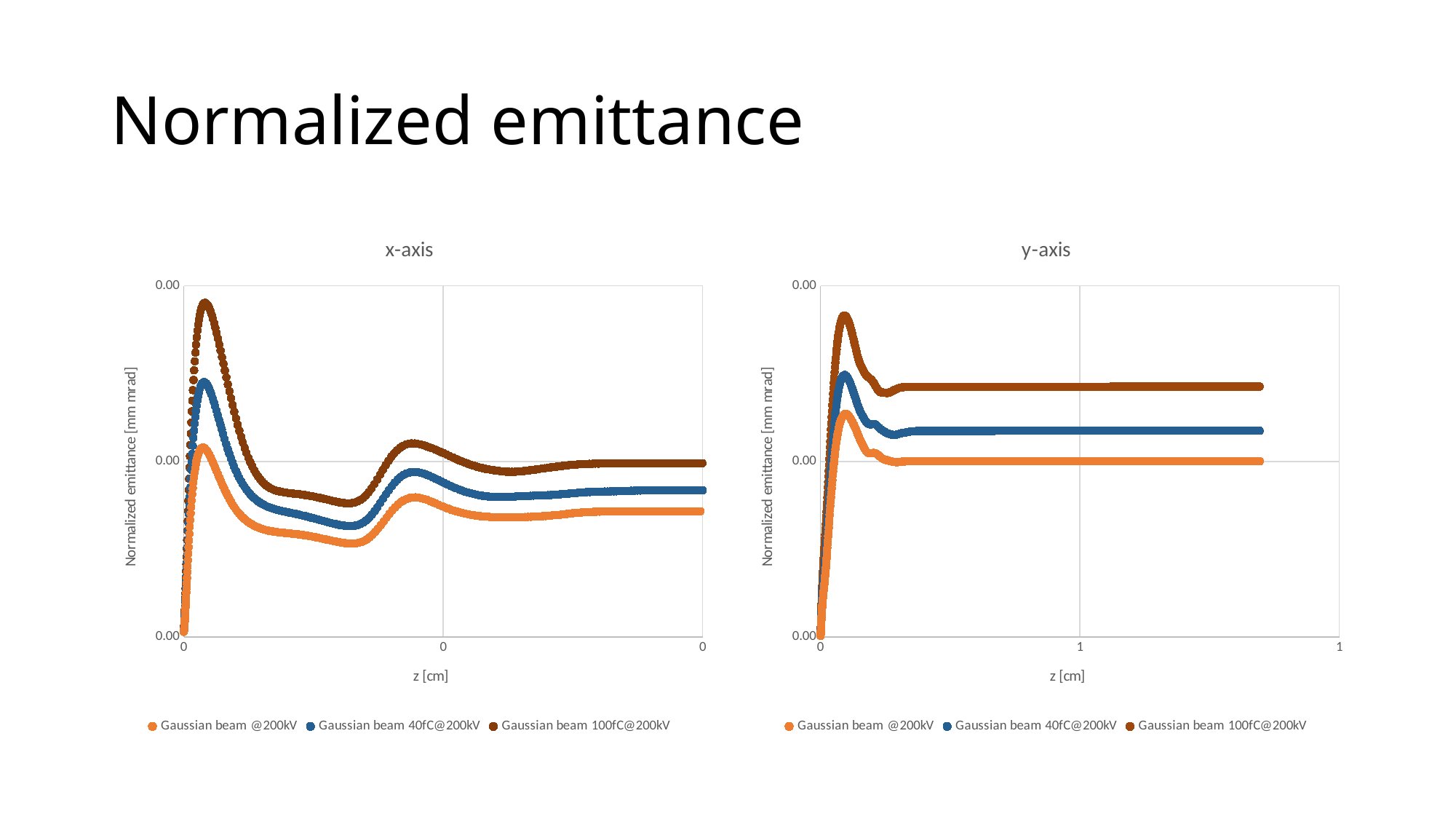
In the y-axis chart, which series is higher at the right end of the plot: Gaussian beam 40fC@200kV or Gaussian beam @200kV? Gaussian beam 40fC@200kV In the y-axis chart, which series reaches the highest peak? Gaussian beam 100fC@200kV How many series does the legend of the y-axis chart list? 3 What is the label of the horizontal axis in the y-axis chart? z [cm] How many series does the legend of the x-axis chart list? 3 What is the label of the vertical axis in the x-axis chart? Normalized emittance [mm mrad] In the y-axis chart, which series has the lowest values along the curve? Gaussian beam @200kV In the x-axis chart, which series is higher at the right end of the plot: Gaussian beam 100fC@200kV or Gaussian beam 40fC@200kV? Gaussian beam 100fC@200kV What kind of chart is the x-axis chart? Scatter chart What kind of chart is the y-axis chart? Scatter chart In the x-axis chart, which series has the lowest values along the curve? Gaussian beam @200kV In the x-axis chart, which series reaches the highest peak? Gaussian beam 100fC@200kV